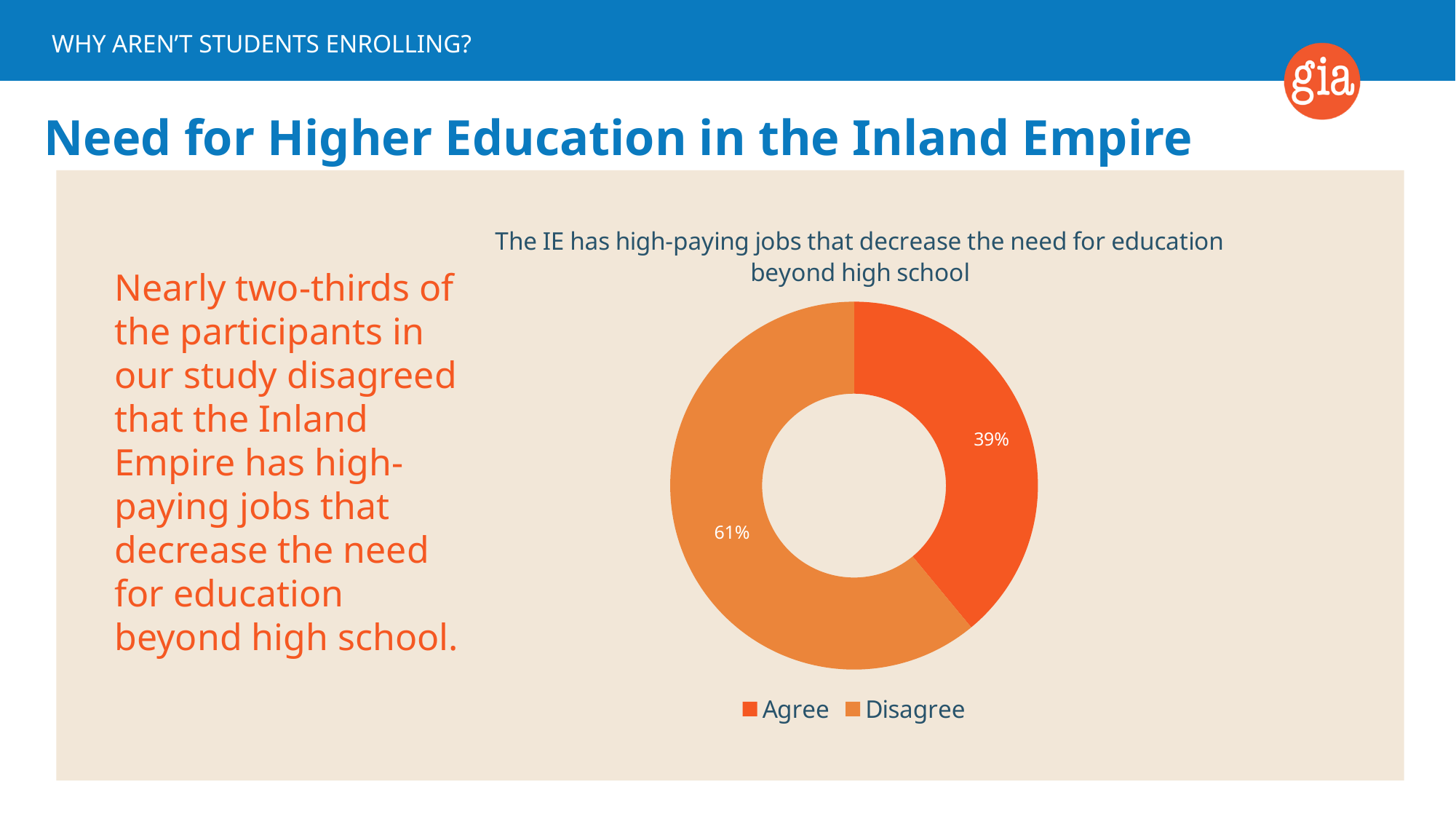
Is the share for Disagree greater or less than 50%? greater What kind of chart is shown on the slide? Doughnut (pie) chart Which legend entry is shown in the darker red-orange colour? Agree Which response has the larger share of the chart, Agree or Disagree? Disagree Is the share for Agree larger or smaller than the share for Disagree? smaller What do the Agree and Disagree shares add up to? 100% What is the difference in percentage points between the Disagree and Agree shares? 22 Which response has the smaller share of the chart? Agree How many categories does the chart show? 2 What is the title of the chart? The IE has high-paying jobs that decrease the need for education beyond high school What percentage of participants agree that the IE has high-paying jobs that decrease the need for education beyond high school? 39% What percentage of participants disagree that the IE has high-paying jobs that decrease the need for education beyond high school? 61%